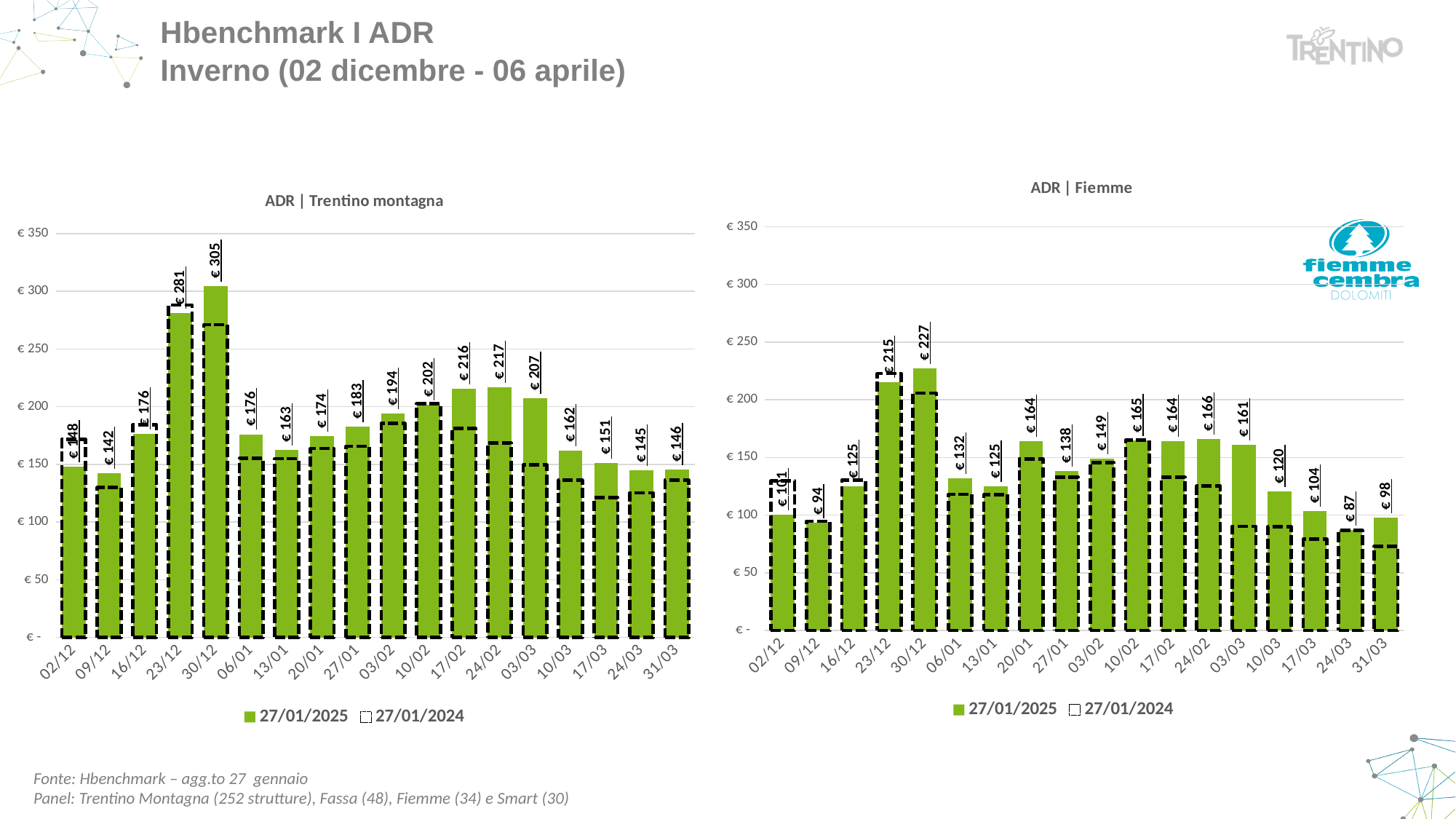
What kind of chart is 'ADR | Fiemme'? Bar chart In the 'ADR | Trentino montagna' chart, which series is drawn with a dashed outline? 27/01/2024 In the 'ADR | Fiemme' chart, what is the value for 20/01 in the 27/01/2025 series? € 164 In the 'ADR | Trentino montagna' chart, what is the difference between the 27/01/2025 values for 23/12 and 16/12? € 105 In the 'ADR | Fiemme' chart, which date has the lowest 27/01/2025 value? 24/03 In the 'ADR | Trentino montagna' chart, which is larger in the 27/01/2025 series: 10/02 or 03/03? 03/03 How many dates are shown on the x axis of the 'ADR | Fiemme' chart? 18 In the 'ADR | Trentino montagna' chart, which date has the highest 27/01/2025 value? 30/12 How many series does the legend of the 'ADR | Trentino montagna' chart list? 2 In the 'ADR | Fiemme' chart, what is the difference between the 27/01/2025 values for 30/12 and 23/12? € 12 In the 'ADR | Fiemme' chart, is the 27/01/2024 (dashed) value for 31/03 greater or less than € 100? less In the 'ADR | Trentino montagna' chart, what is the value for 30/12 in the 27/01/2025 series? € 305